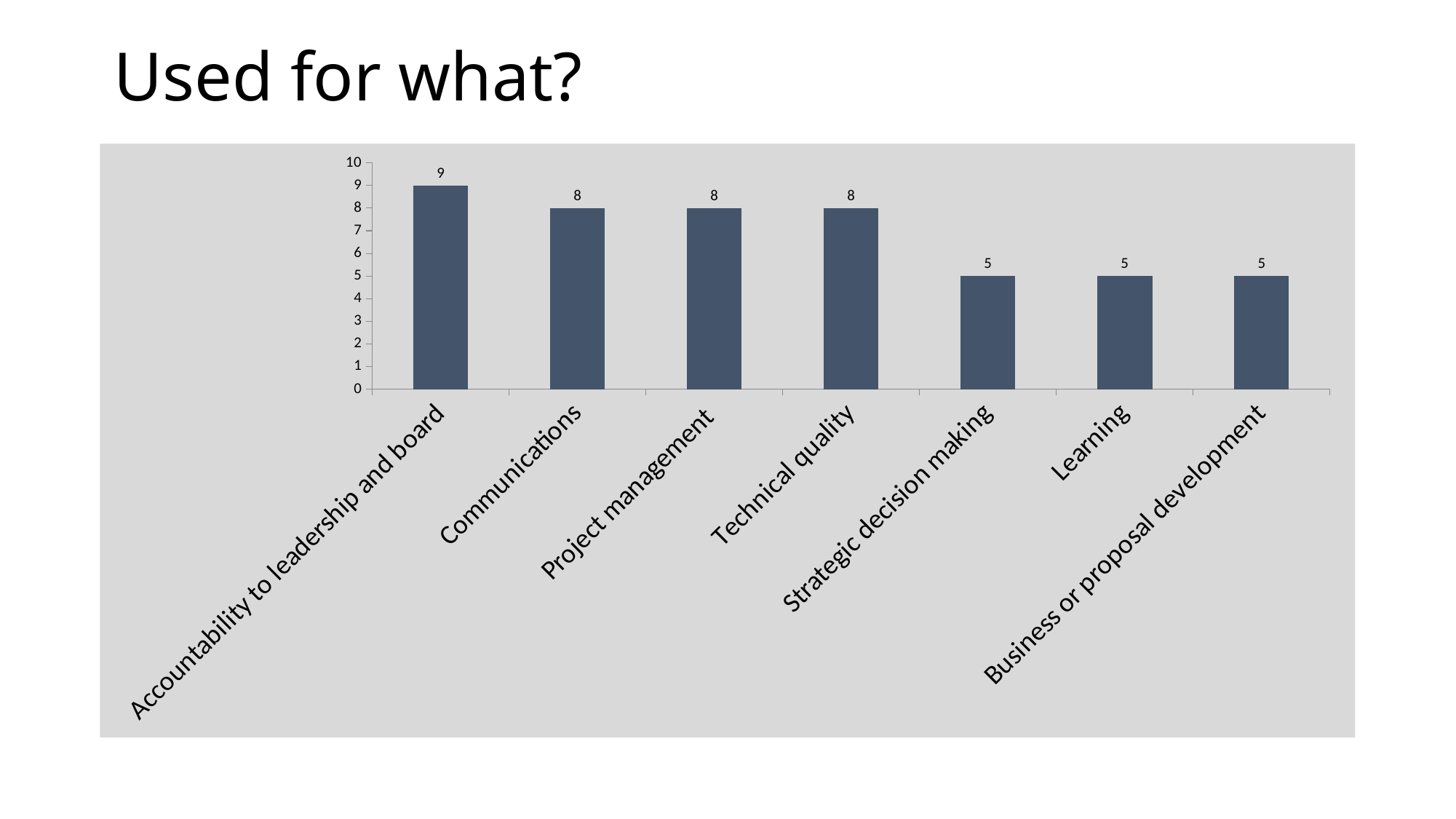
What is the difference between the values for Accountability to leadership and board and Learning? 4 How many categories are shown on the chart? 7 What is the value for Strategic decision making? 5 What is the title of the slide? Used for what? What is the value for Accountability to leadership and board? 9 What is the difference between the values for Technical quality and Strategic decision making? 3 Which is larger, the value for Project management or the value for Learning? Project management What is the value for Communications? 8 Do the values rise or fall from left to right along the x axis? Fall Which category has the highest value? Accountability to leadership and board What kind of chart is shown on the slide? Bar chart What is the value for Business or proposal development? 5